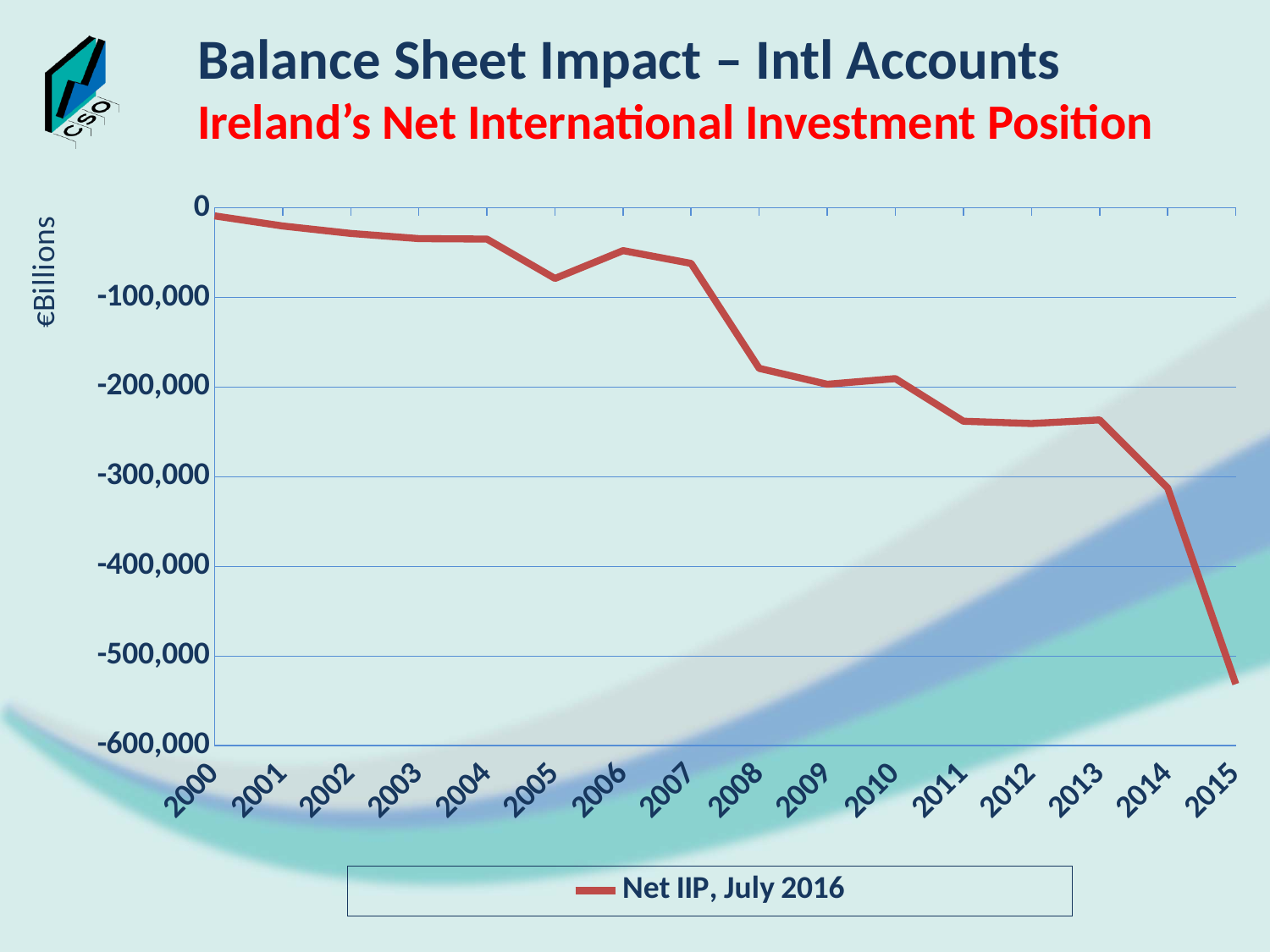
Is the value for 2014 greater or less than -300,000? less Is the value for 2005 greater or less than -100,000? greater Which year has the higher (less negative) value, 2005 or 2008? 2005 What is the label on the vertical axis? €Billions How many series does the legend list? 1 Do the values generally rise or fall from 2000 to 2015? fall In which year is Ireland's Net International Investment Position at its highest (closest to zero)? 2000 Is the value for 2015 greater or less than -500,000? less What is the legend entry for the plotted line? Net IIP, July 2016 In which year is Ireland's Net International Investment Position at its lowest (most negative)? 2015 How many years are plotted along the x axis? 16 What kind of chart is shown on the slide? line chart